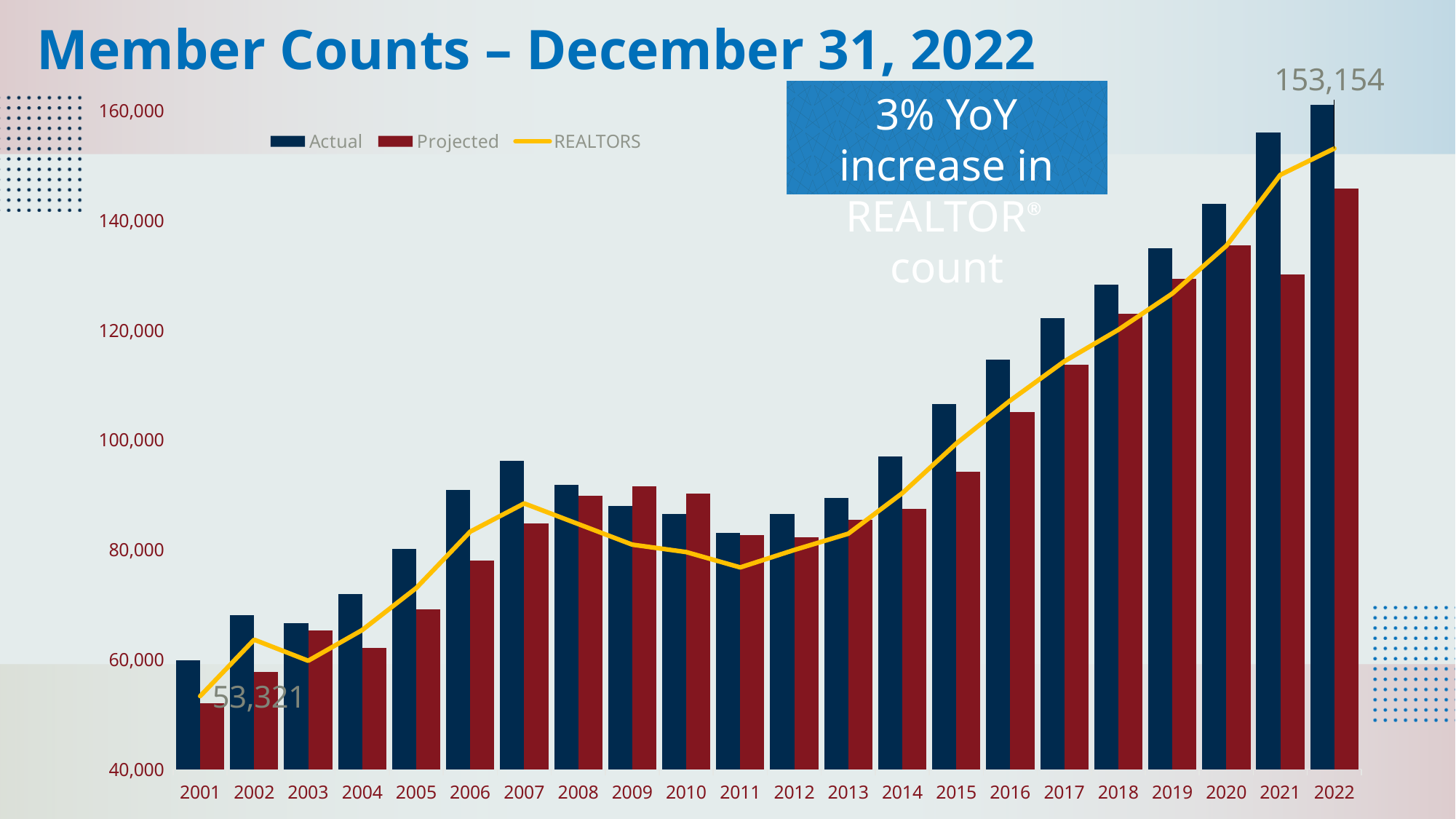
What is the difference between the REALTORS value in 2022 and in 2001? 99,833 What kind of chart is shown on the slide? bar chart with a line Does the REALTORS line rise or fall from 2013 to 2022? rises How many years are shown on the x axis? 22 In 2020, which is larger, the Actual bar or the Projected bar? Actual Which year has the lowest Projected bar? 2001 Is the Actual value for 2015 greater or less than 100,000? greater Which year has the highest Actual bar? 2022 Is the Projected value for 2022 greater or less than 140,000? greater How many series does the legend list? 3 What is the REALTORS value for 2022? 153,154 What is the REALTORS value for 2001? 53,321